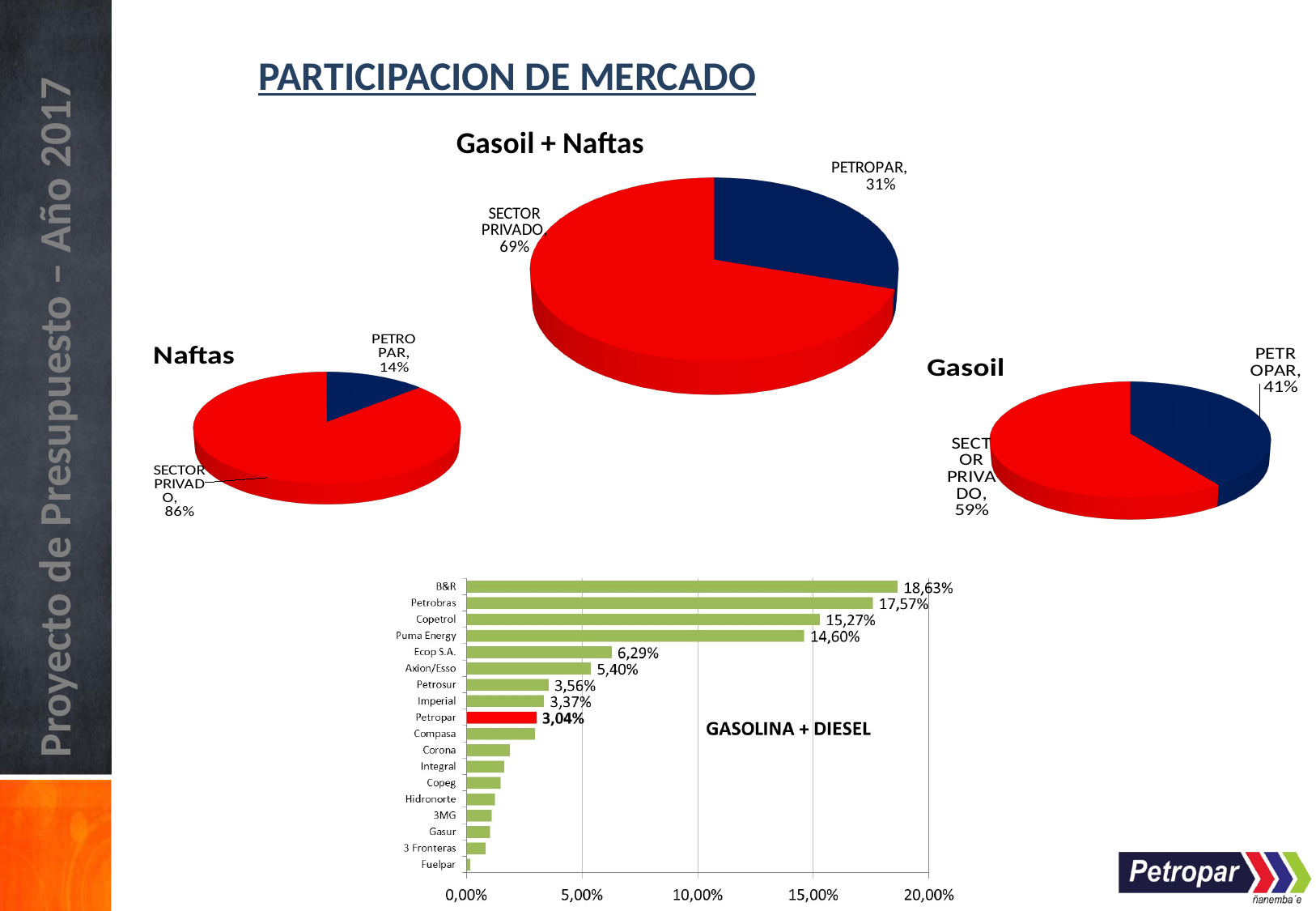
In the GASOLINA + DIESEL bar chart, which company has the lowest value? Fuelpar In the GASOLINA + DIESEL bar chart, what colour is the bar for Petropar? red In the GASOLINA + DIESEL bar chart, what is the value for Petropar? 3,04% What kind of chart is the GASOLINA + DIESEL chart at the bottom of the slide? bar chart In the GASOLINA + DIESEL bar chart, which is larger, Copetrol or Puma Energy? Copetrol In the Gasoil + Naftas pie chart, what share does PETROPAR have? 31% In the GASOLINA + DIESEL bar chart, what is the difference between the values for B&R and Petrobras? 1,06% In the GASOLINA + DIESEL bar chart, which company has the highest value? B&R In the GASOLINA + DIESEL bar chart, is the value for Compasa greater or less than 5,00%? less In the Naftas pie chart, what share does SECTOR PRIVADO have? 86% In the Gasoil pie chart, what share does PETROPAR have? 41% How many companies are listed in the GASOLINA + DIESEL bar chart? 18